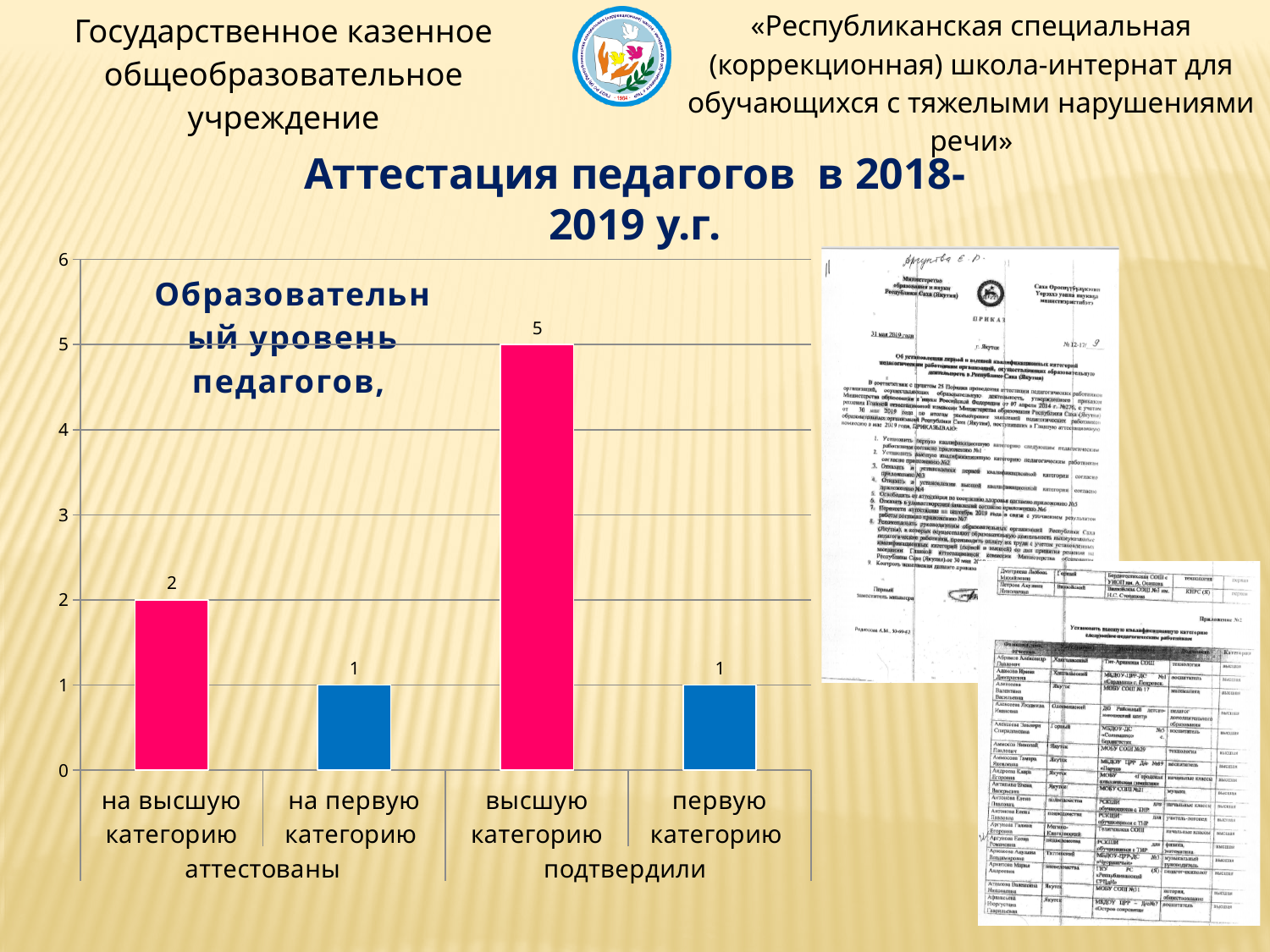
How many bars are plotted in the chart? 4 What is the highest value shown on the vertical axis of the chart? 6 What kind of chart is shown on the slide? bar chart What is the value for "высшую категорию" in the "подтвердили" group? 5 Which category has the highest value in the chart? высшую категорию (подтвердили) What is the value for "первую категорию" in the "подтвердили" group? 1 What are the two group labels shown below the category labels on the x axis? аттестованы, подтвердили Which is larger: the value for "на высшую категорию" (аттестованы) or "на первую категорию" (аттестованы)? на высшую категорию Is the value for "высшую категорию" (подтвердили) greater or less than 4? greater What is the value for "на высшую категорию" in the "аттестованы" group? 2 What is the value for "на первую категорию" in the "аттестованы" group? 1 What is the difference between the value for "высшую категорию" (подтвердили) and "на высшую категорию" (аттестованы)? 3